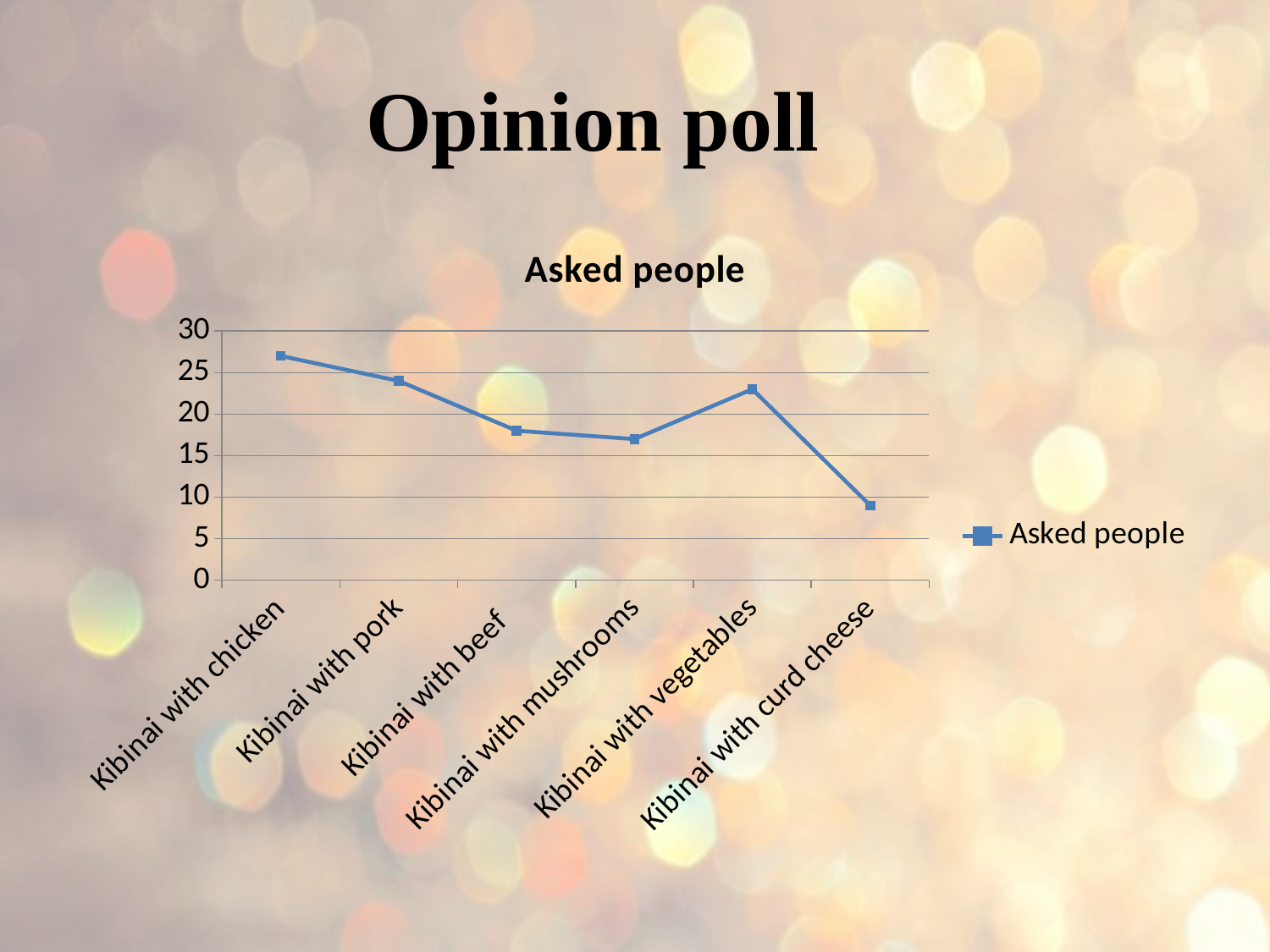
Which category has the lowest value in the chart? Kibinai with curd cheese Is the value for Kibinai with vegetables greater or less than 20? greater Is the value for Kibinai with chicken greater or less than 25? greater What is the title of the chart? Asked people Is the value for Kibinai with beef greater or less than 20? less How many categories are plotted on the x axis of the chart? 6 Which is larger, the value for Kibinai with chicken or the value for Kibinai with pork? Kibinai with chicken How many series does the legend list? 1 Which category has the highest value in the chart? Kibinai with chicken Which is larger, the value for Kibinai with beef or the value for Kibinai with vegetables? Kibinai with vegetables What kind of chart is shown on the slide? line chart